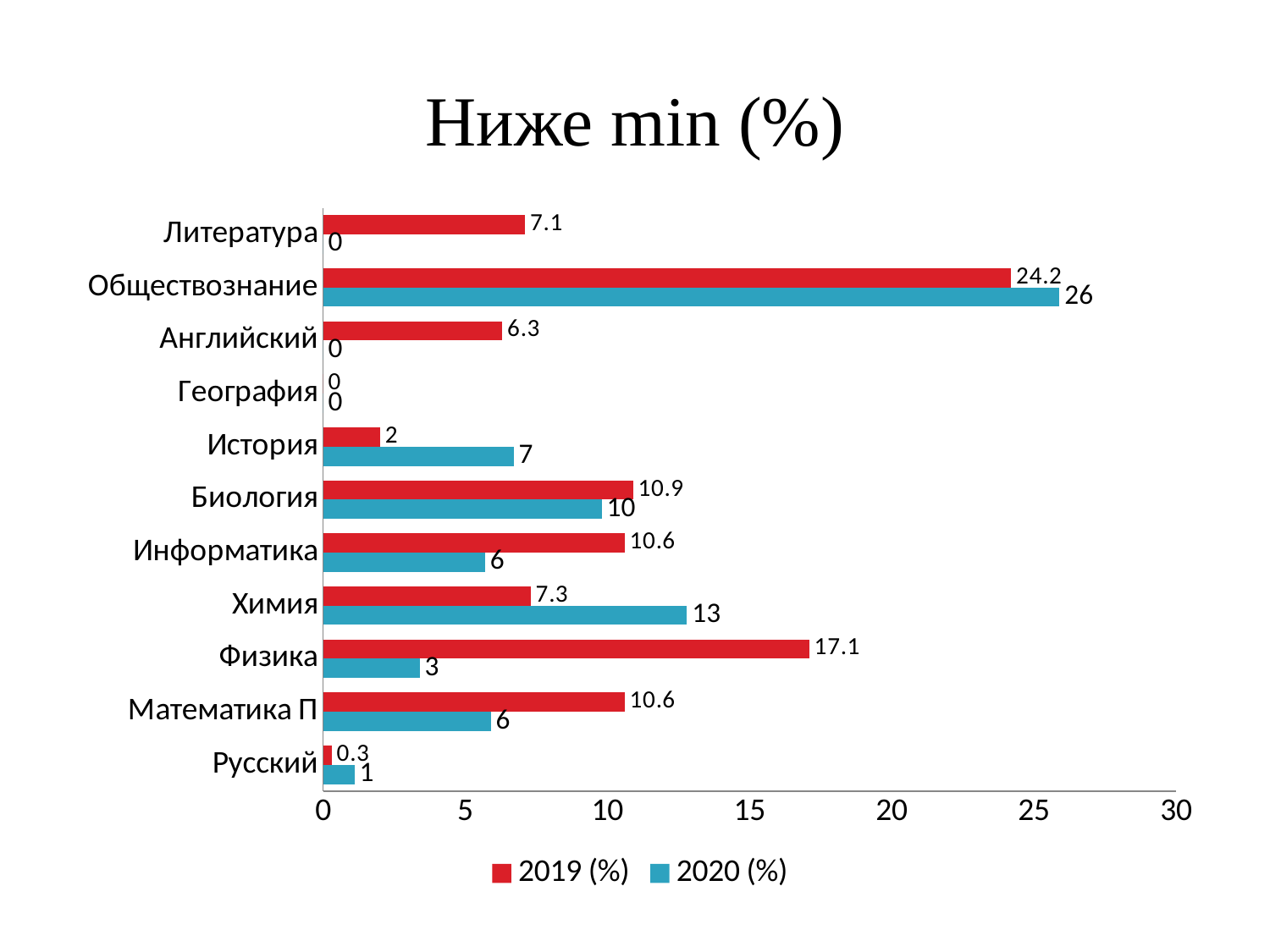
What is the title of the chart? Ниже min (%) Which is larger for История: the 2019 (%) value or the 2020 (%) value? 2020 (%) What is the 2020 (%) value for Химия? 13 What is the 2019 (%) value for Физика? 17.1 Is the 2019 (%) value for Обществознание greater or less than 20? greater Which category has the lowest 2019 (%) value? География What kind of chart is shown on the slide? bar chart How many categories are shown on the chart? 11 Which category has the highest 2020 (%) value? Обществознание What is the 2019 (%) value for Обществознание? 24.2 What is the difference between the 2019 (%) and 2020 (%) values for Физика? 14.1 How many series does the legend list? 2